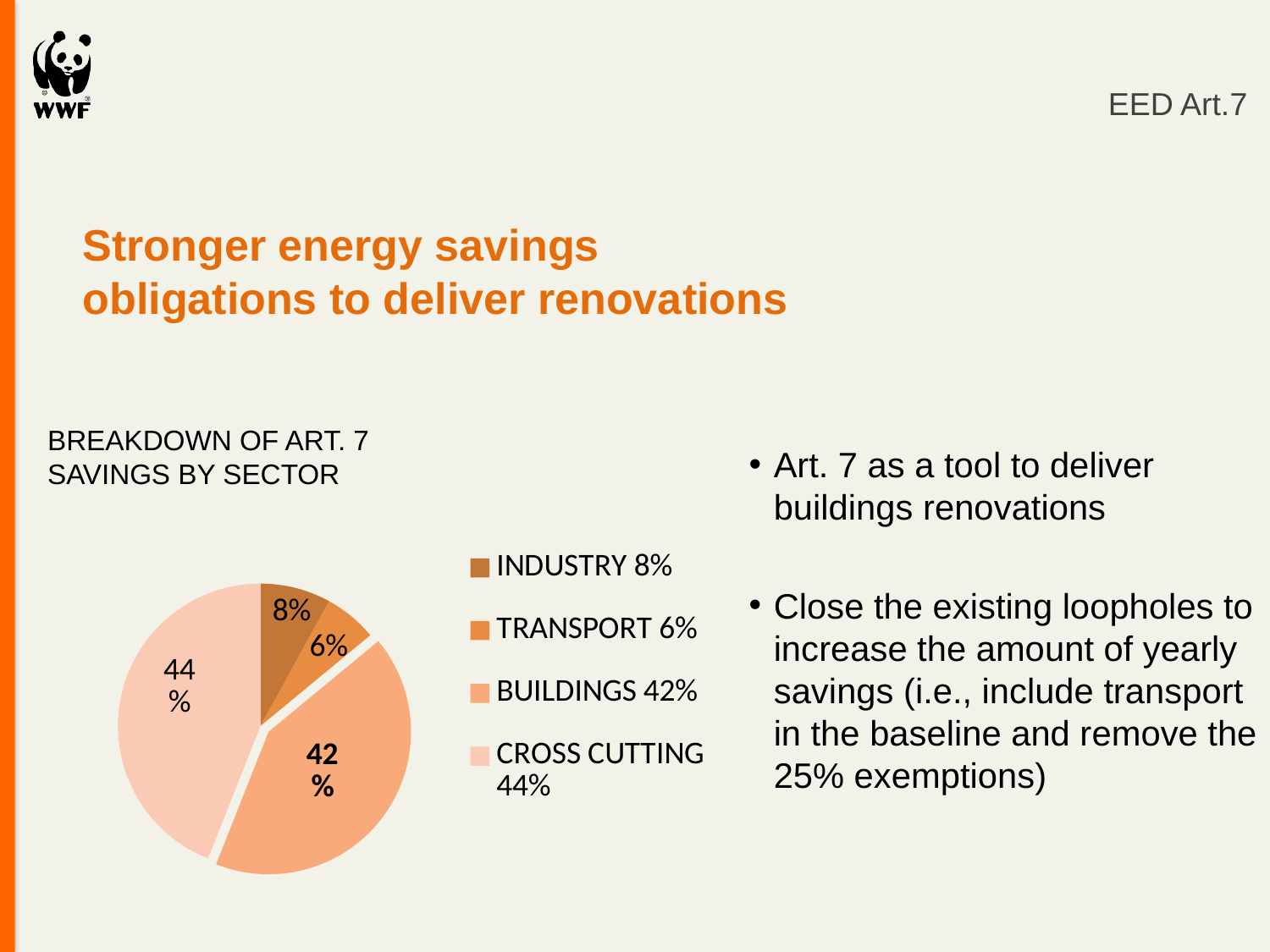
What is the title of the pie chart? BREAKDOWN OF ART. 7 SAVINGS BY SECTOR Which sector has the smallest share of Art. 7 savings? Transport What kind of chart is shown on the slide? pie chart What is the difference in percentage points between the Cross Cutting and Buildings shares? 2 What share of Art. 7 savings comes from Transport? 6% Which is larger, the Industry share or the Transport share? Industry Which sector has the largest share of Art. 7 savings? Cross Cutting What share of Art. 7 savings comes from Industry? 8% What share of Art. 7 savings comes from Buildings? 42% How many sectors are shown in the pie chart? 4 What is the combined share of Industry and Transport? 14% What share of Art. 7 savings comes from Cross Cutting? 44%